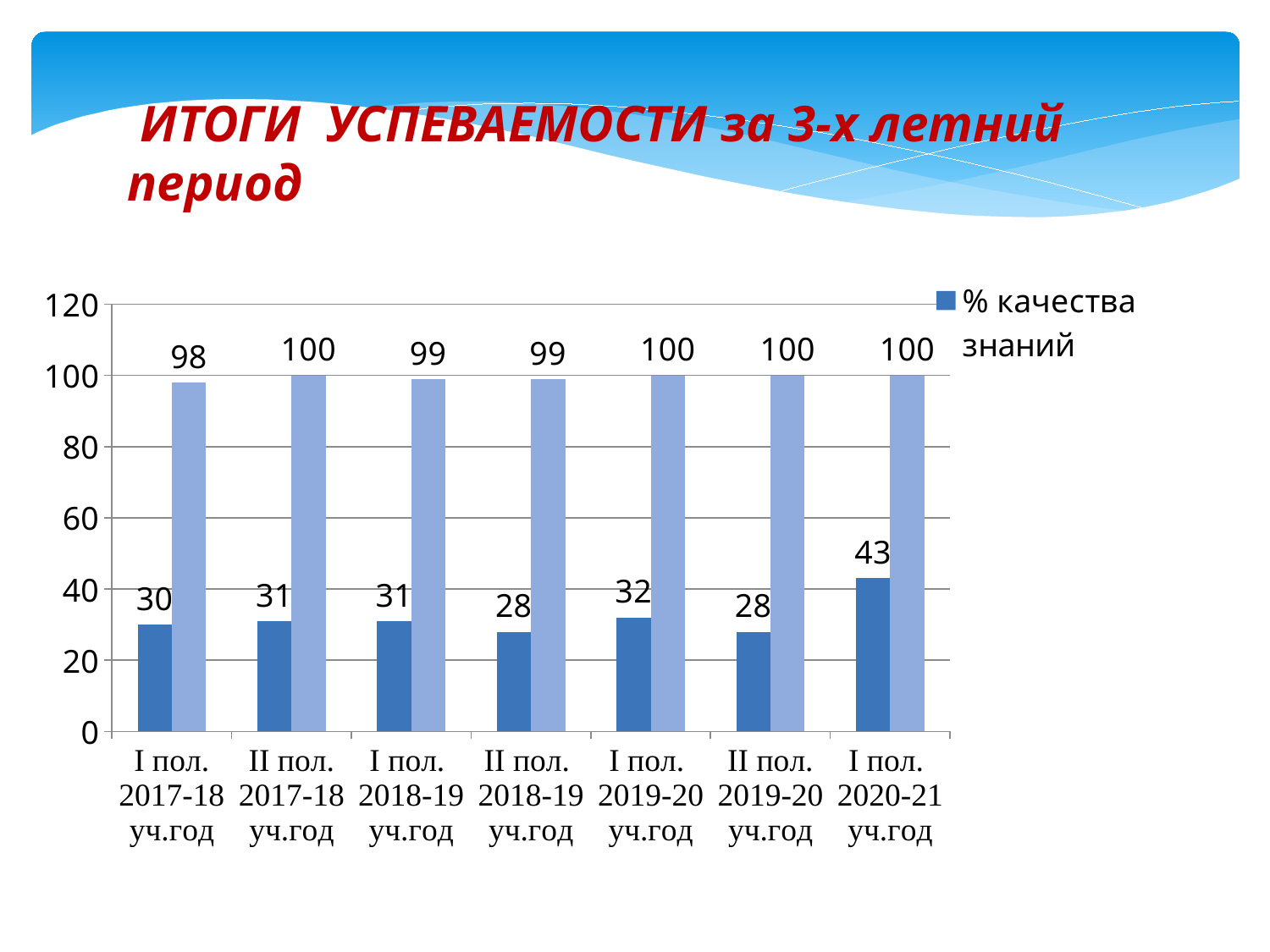
What is the lowest value shown for % качества знаний? 28 What is the difference between the light blue bars for II пол. 2017-18 уч.год and I пол. 2017-18 уч.год? 2 What is the title of the slide? ИТОГИ УСПЕВАЕМОСТИ за 3-х летний период What kind of chart is shown on the slide? bar chart What is the value of % качества знаний for I пол. 2017-18 уч.год? 30 Which has a higher % качества знаний: I пол. 2019-20 уч.год or II пол. 2019-20 уч.год? I пол. 2019-20 уч.год How many periods are shown on the x axis? 7 Which period has the highest % качества знаний? I пол. 2020-21 уч.год What is the value of % качества знаний for I пол. 2020-21 уч.год? 43 What is the difference in % качества знаний between I пол. 2020-21 уч.год and I пол. 2019-20 уч.год? 11 Is the % качества знаний for I пол. 2020-21 уч.год greater or less than 40? greater What is the value of the light blue bar for I пол. 2017-18 уч.год? 98